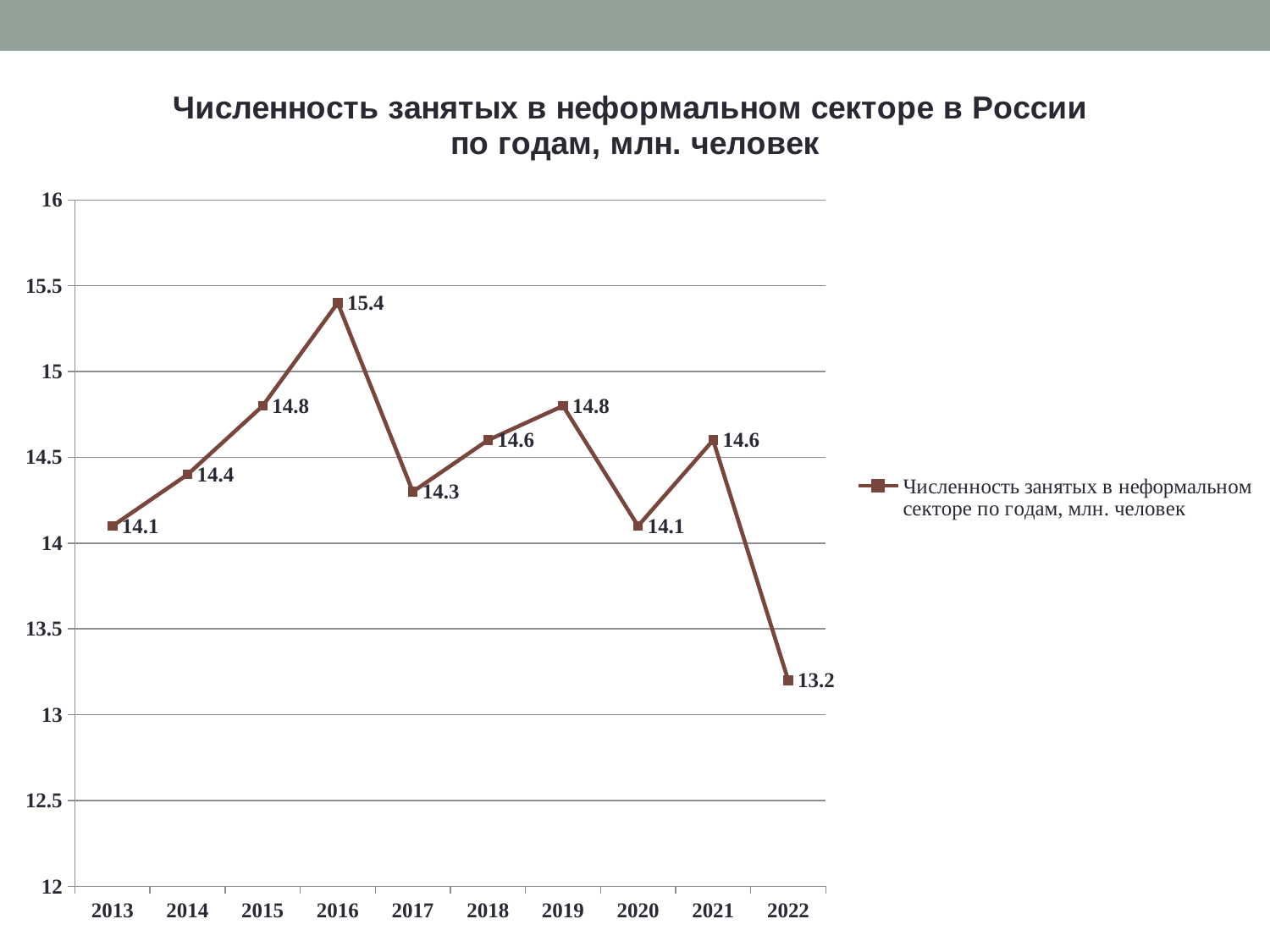
How many years are plotted on the chart? 10 Which year has the lowest value? 2022 Which year has the highest value? 2016 What was the number of people employed in the informal sector in 2016? 15.4 What is the difference between the values for 2021 and 2022? 1.4 Is the value for 2020 greater or less than 14.5? less What kind of chart is shown on the slide? line chart Does the value rise or fall from 2019 to 2020? fall Which is larger, the value for 2015 or the value for 2018? 2015 What value is shown for 2013? 14.1 What value is shown for 2022? 13.2 What is the difference between the values for 2016 and 2017? 1.1